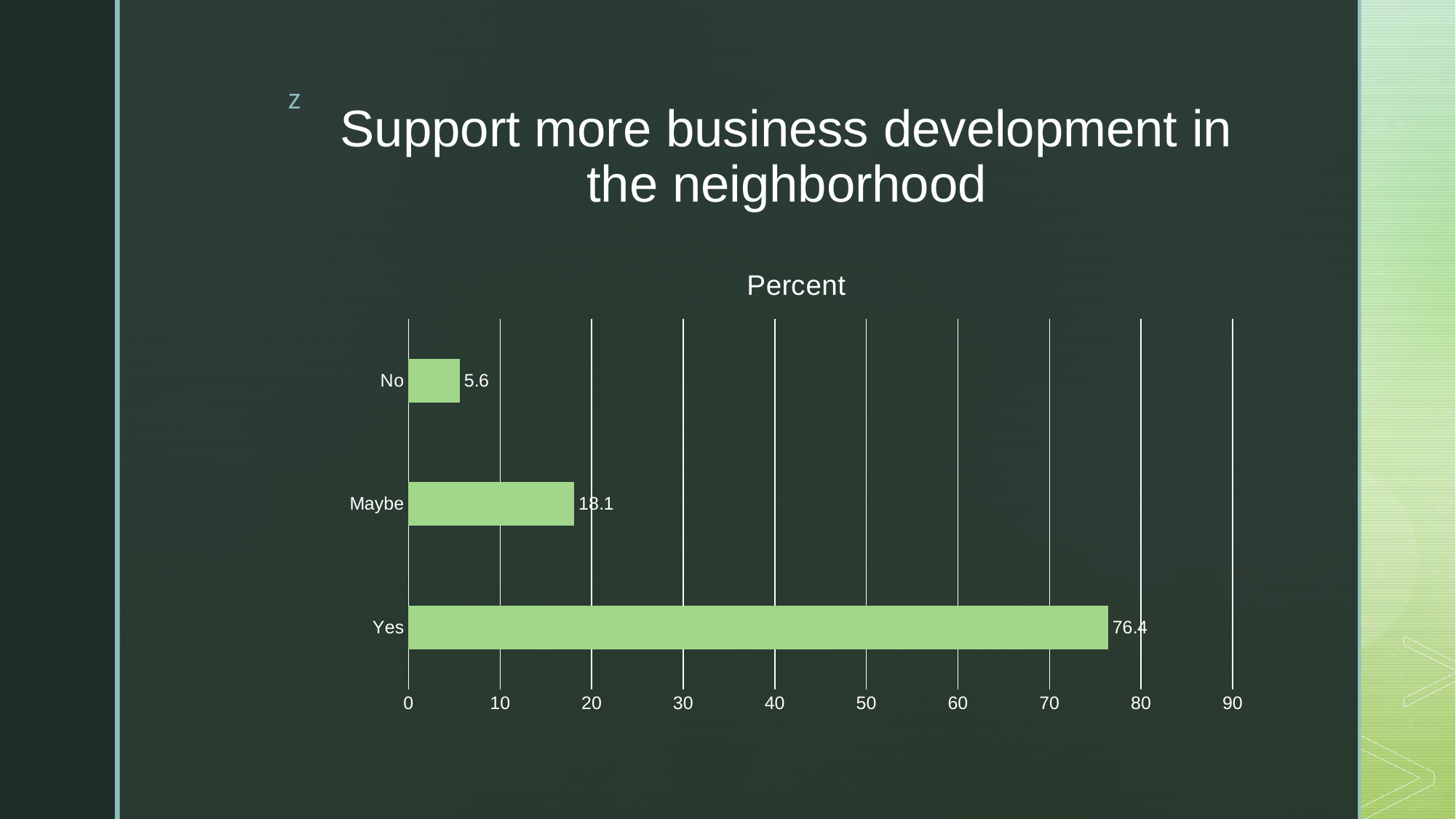
Which category has the highest value? Yes What is the value for Yes? 76.4 How many categories are shown in the chart? 3 What is the difference between the values for Yes and Maybe? 58.3 What kind of chart is shown on the slide? bar chart What is the difference between the values for Maybe and No? 12.5 Which is larger, the value for Maybe or the value for No? Maybe What is the value for No? 5.6 Which category has the lowest value? No What is the value for Maybe? 18.1 What is the title of the chart? Percent Is the value for Yes greater or less than 70? greater